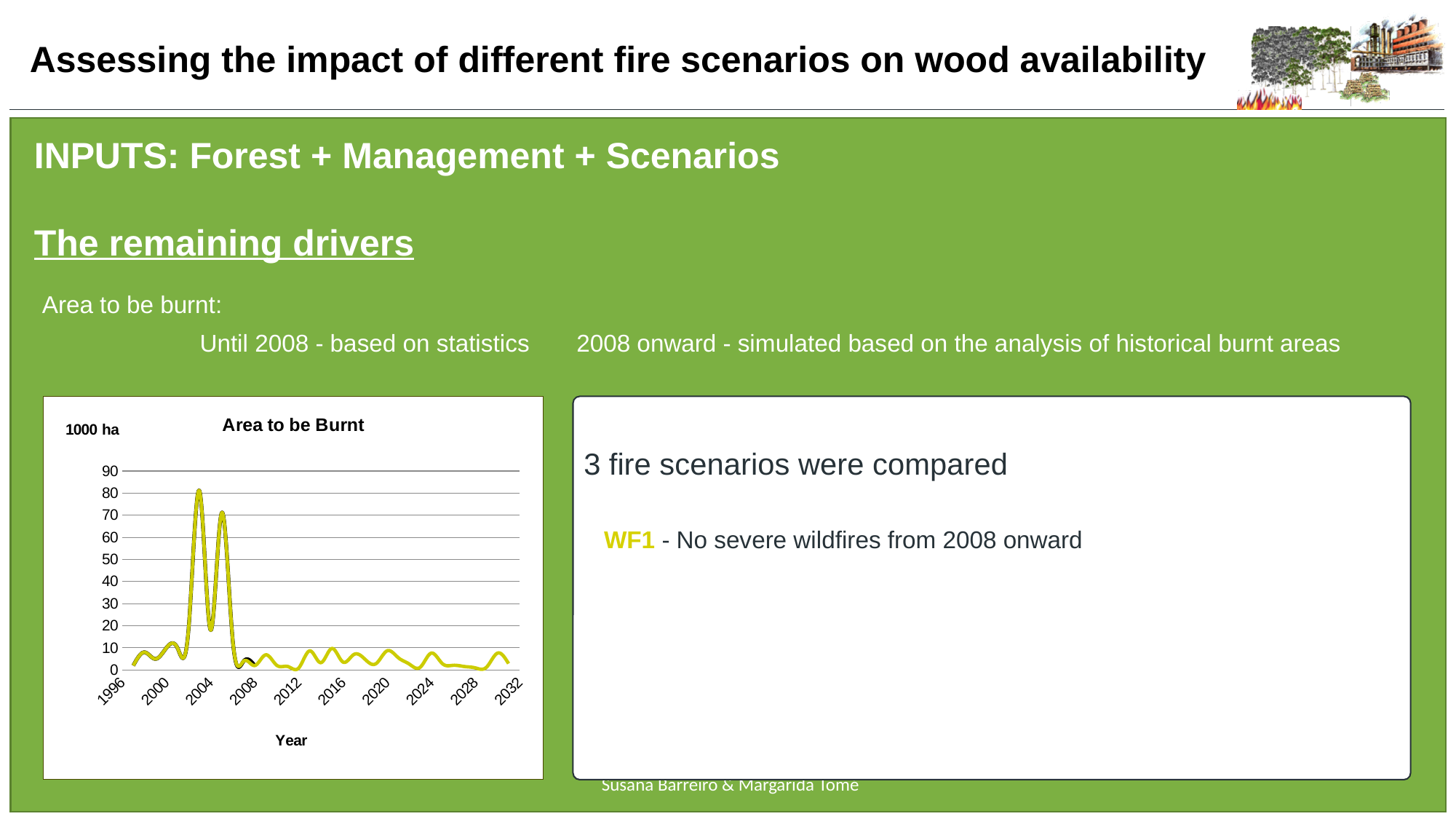
What unit is shown on the vertical axis of the 'Area to be Burnt' chart? 1000 ha Is the value for 2020 on the 'Area to be Burnt' chart greater or less than 20? less What is the last year shown on the horizontal axis of the 'Area to be Burnt' chart? 2032 Is the highest value plotted on the 'Area to be Burnt' chart greater or less than 70? greater What is the first year shown on the horizontal axis of the 'Area to be Burnt' chart? 1996 On the 'Area to be Burnt' chart, do the values from 2008 onward stay low or rise to the levels seen around 2004? stay low Is the value for 1996 on the 'Area to be Burnt' chart greater or less than 30? less How many year tick labels are shown on the horizontal axis of the 'Area to be Burnt' chart? 10 What is the title of the chart on the slide? Area to be Burnt What kind of chart is the 'Area to be Burnt' chart? line chart What is the highest tick value shown on the vertical axis of the 'Area to be Burnt' chart? 90